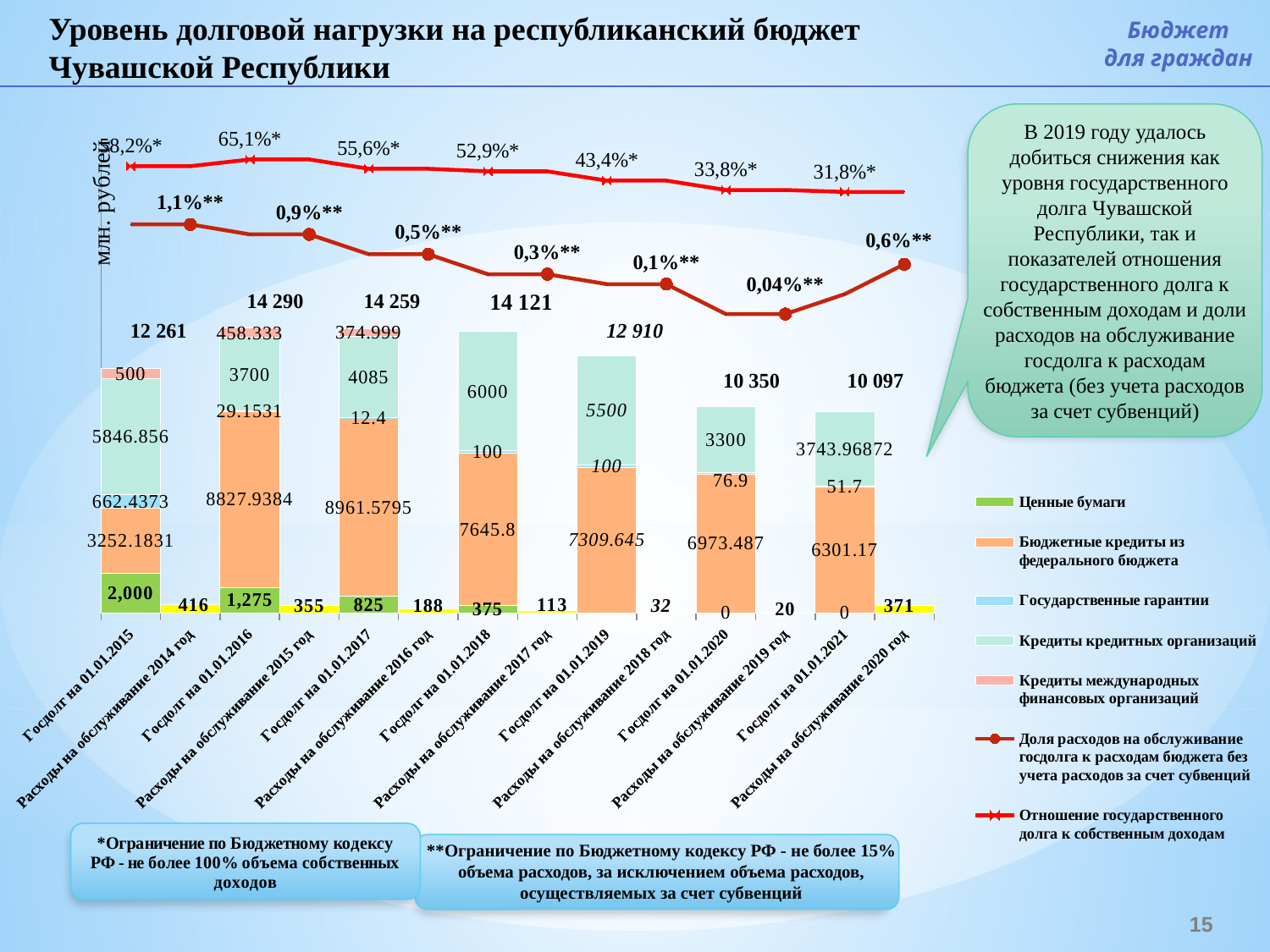
Which 'Госдолг' bar has the lowest total? Госдолг на 01.01.2021 How many entries does the legend list? 7 What is the value of 'Доля расходов на обслуживание госдолга к расходам бюджета' for 2019? 0,04% What is the total value of the bar for 'Госдолг на 01.01.2016'? 14 290 Which is larger: 'Расходы на обслуживание 2014 год' or 'Расходы на обслуживание 2020 год'? Расходы на обслуживание 2014 год Does 'Отношение государственного долга к собственным доходам' rise or fall from 01.01.2016 to 01.01.2021? Falls What is the difference between the total for 'Госдолг на 01.01.2016' and the total for 'Госдолг на 01.01.2021'? 4 193 What kind of chart is shown on the slide? A stacked bar chart combined with line charts What is the value of 'Бюджетные кредиты из федерального бюджета' in the bar for 'Госдолг на 01.01.2020'? 6973.487 What is the value for 'Расходы на обслуживание 2019 год'? 20 What is the value of 'Отношение государственного долга к собственным доходам' at 01.01.2016? 65,1% Which 'Госдолг' bar has the highest total? Госдолг на 01.01.2016